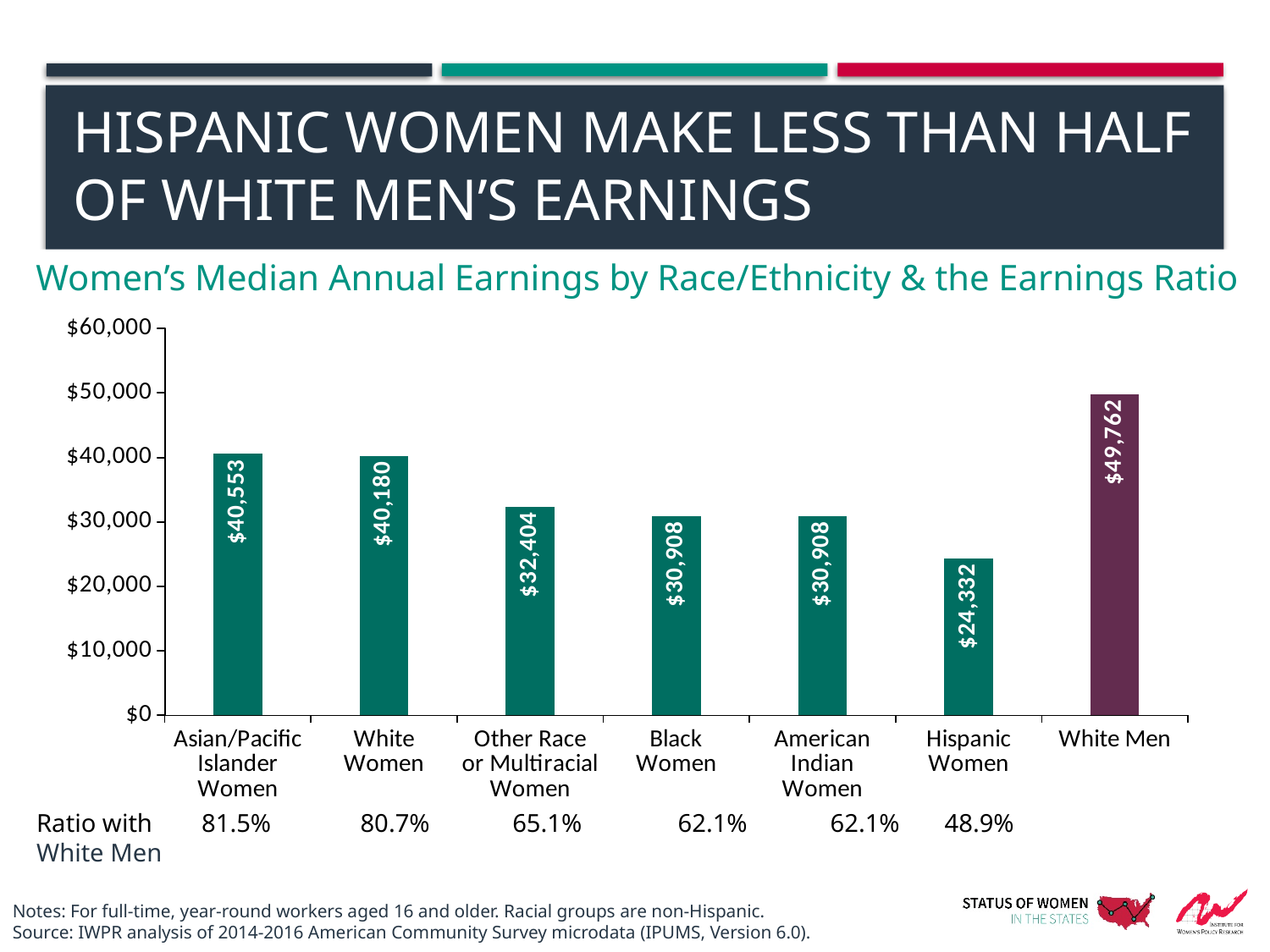
What kind of chart is shown on the slide? bar chart Is the value for American Indian Women greater or less than $40,000? less What is the median annual earnings value shown for Hispanic Women? $24,332 How many categories are shown on the x axis of the chart? 7 What is the median annual earnings value shown for Other Race or Multiracial Women? $32,404 Which category has the lowest median annual earnings on the chart? Hispanic Women Which is larger, the median annual earnings of Other Race or Multiracial Women or of Black Women? Other Race or Multiracial Women What is the difference between the median annual earnings of Asian/Pacific Islander Women and White Women? $373 What is the ratio with White Men shown for Black Women? 62.1% Which category has the highest median annual earnings on the chart? White Men What is the median annual earnings value shown for White Men? $49,762 What is the difference between the median annual earnings of White Men and Hispanic Women? $25,430